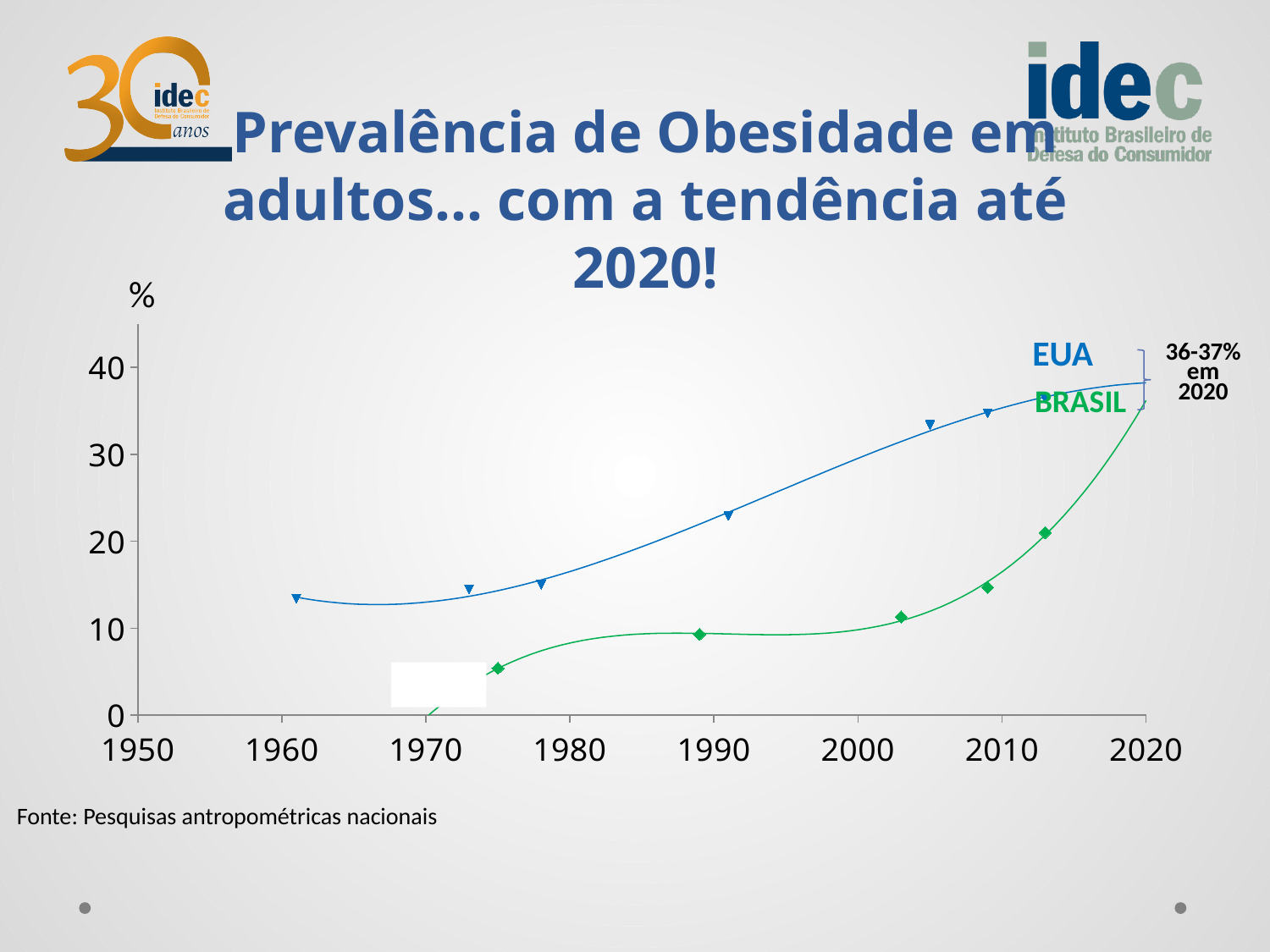
Is the value for BRASIL at its first data point (around 1975) greater or less than 10? less Is the value for EUA around 2009 greater or less than 30? greater Around 1990, which series has the higher value, EUA or BRASIL? EUA How many series does the chart show? 2 What value does the annotation at the right of the chart give for 2020? 36-37% Does the BRASIL series rise or fall from 1975 to 2020? rise Is the value for EUA at its first data point (around 1961) greater or less than 10? greater What unit is shown on the vertical axis of the chart? % What kind of chart is shown on the slide? line chart What are the names of the two series plotted on the chart? EUA and BRASIL Does the EUA series rise or fall from 1960 to 2020? rise